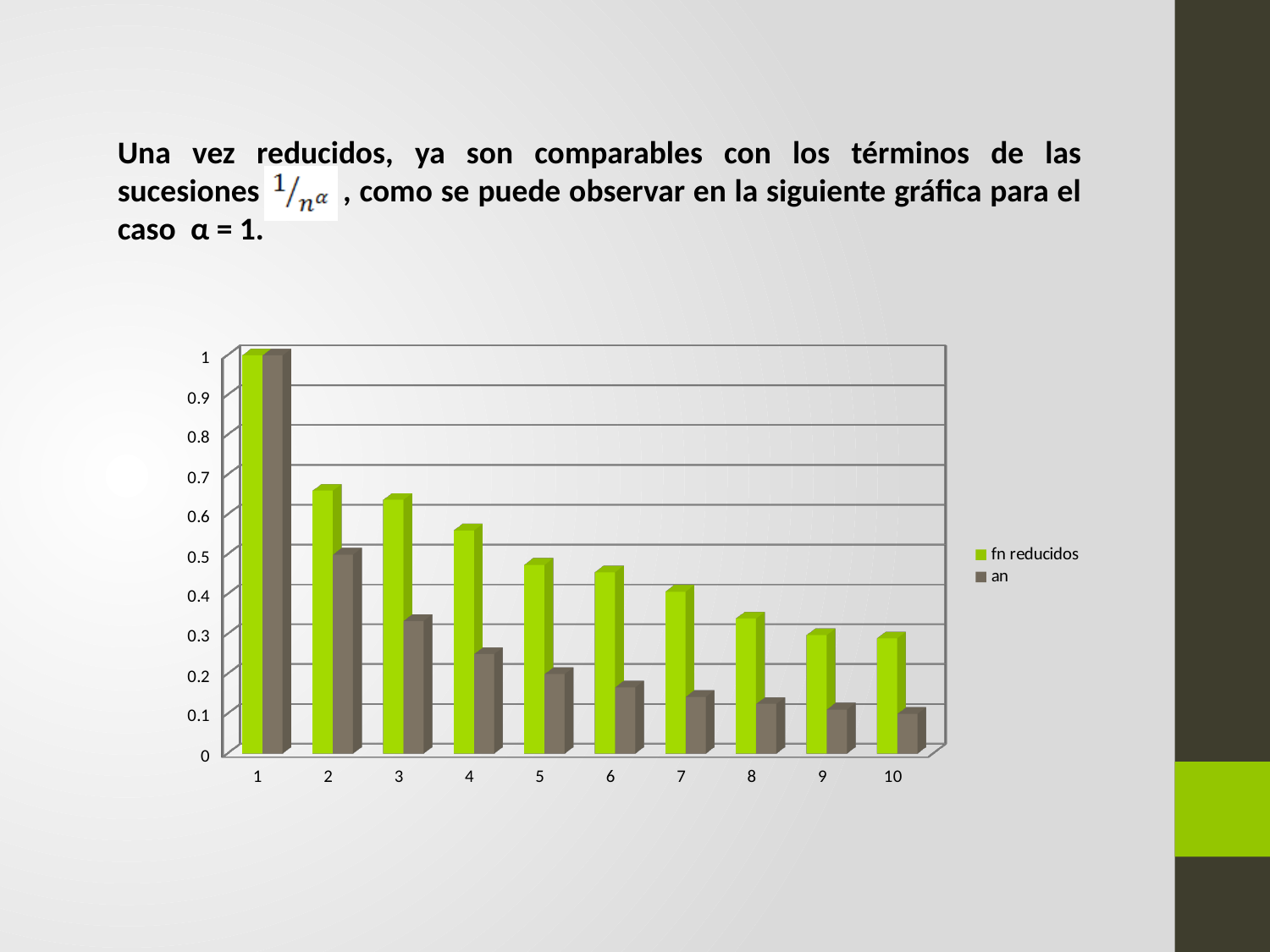
Is the value of 'fn reducidos' for category 4 greater or less than 0.5? greater What is the value of 'an' for category 1? 1 Do the values of 'an' rise or fall as the category number increases from 1 to 10? fall For category 5, which series has the larger value, 'fn reducidos' or 'an'? fn reducidos How many series does the legend list? 2 For which category is 'an' lowest? 10 What kind of chart is shown on the slide? bar chart Is the value of 'an' for category 8 greater or less than 0.2? less How many categories are shown on the x axis? 10 Is the value of 'fn reducidos' for category 8 greater or less than 0.4? less For which category is 'fn reducidos' highest? 1 What is the value of 'an' for category 2? 0.5